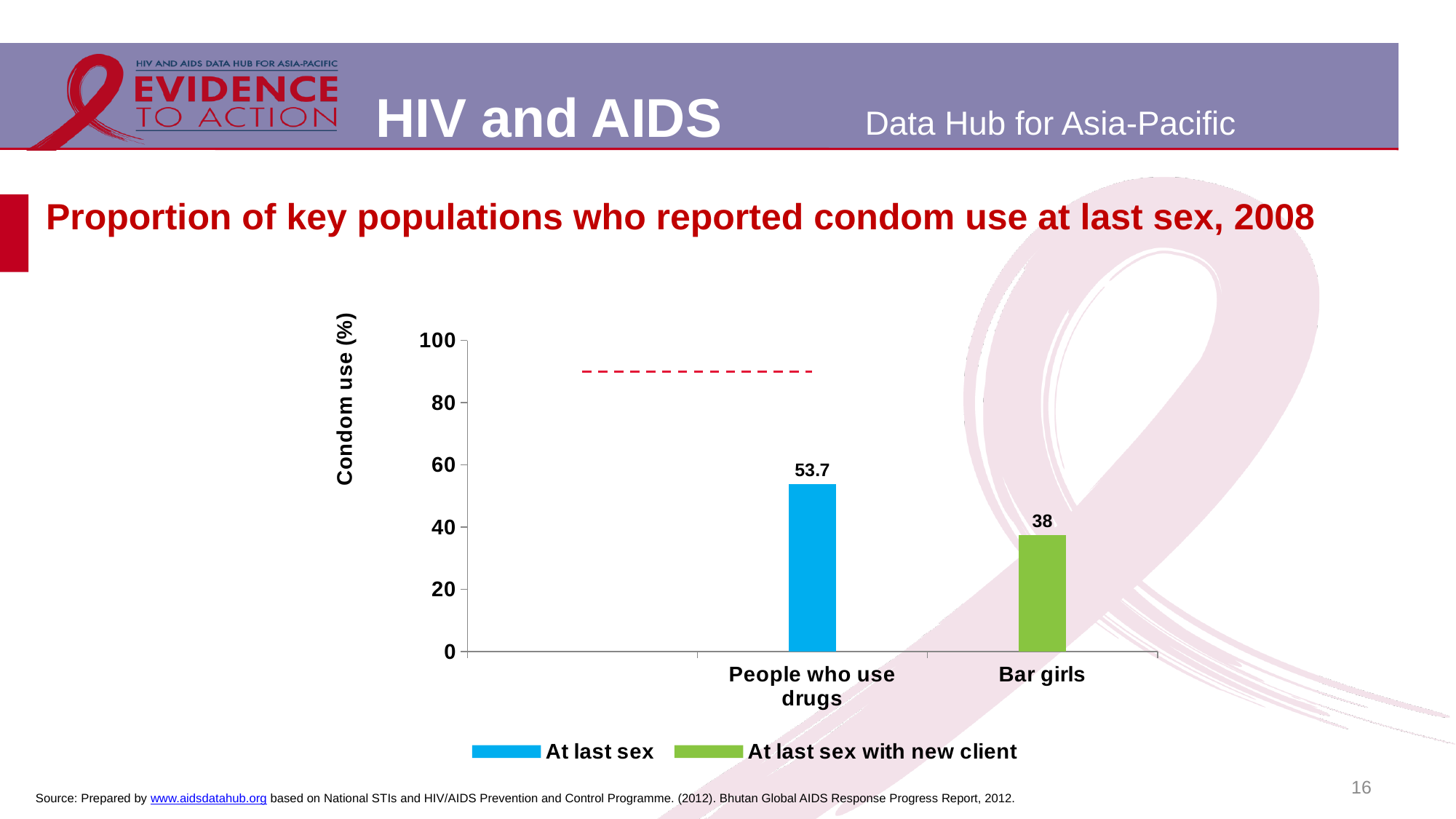
Which category has the highest condom use value? People who use drugs Which category has the lowest condom use value? Bar girls What is the difference between the value for People who use drugs and the value for Bar girls? 15.7 What is the value for Bar girls? 38 Is the value for People who use drugs greater or less than 60? less Which is larger, the value for People who use drugs or the value for Bar girls? People who use drugs How many categories are shown on the x axis? 2 How many series does the legend list? 2 Is the value for Bar girls greater or less than 40? less What is the value for People who use drugs? 53.7 What is the label of the y axis? Condom use (%) What kind of chart is shown on the slide? Bar chart